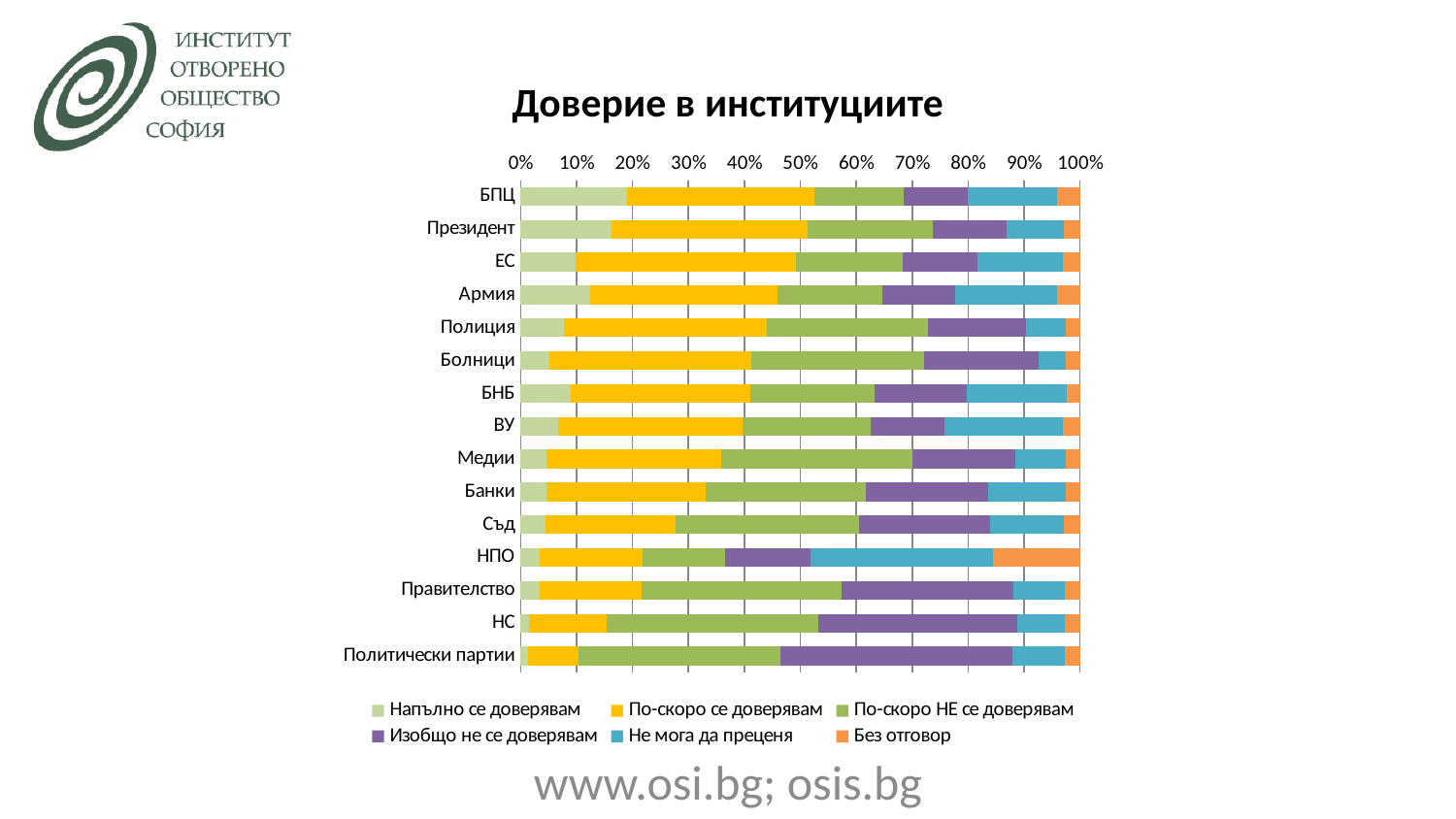
Which institution has the largest "Не мога да преценя" segment? НПО How many institutions (categories) are plotted in the chart? 15 Which institution has the largest "Напълно се доверявам" segment? БПЦ Which has a larger "По-скоро се доверявам" segment, БПЦ or Съд? БПЦ Is the "Напълно се доверявам" value for БПЦ greater or less than 10%? greater What is the title of the chart? Доверие в институциите Is the "Напълно се доверявам" value for Политически партии greater or less than 10%? less What kind of chart is shown on the slide? Stacked bar chart Which colour represents the series "Без отговор" in the chart? Orange Which institution has the largest "Изобщо не се доверявам" segment? Политически партии How many series does the legend list? 6 Which has a larger "Напълно се доверявам" segment, БПЦ or Политически партии? БПЦ